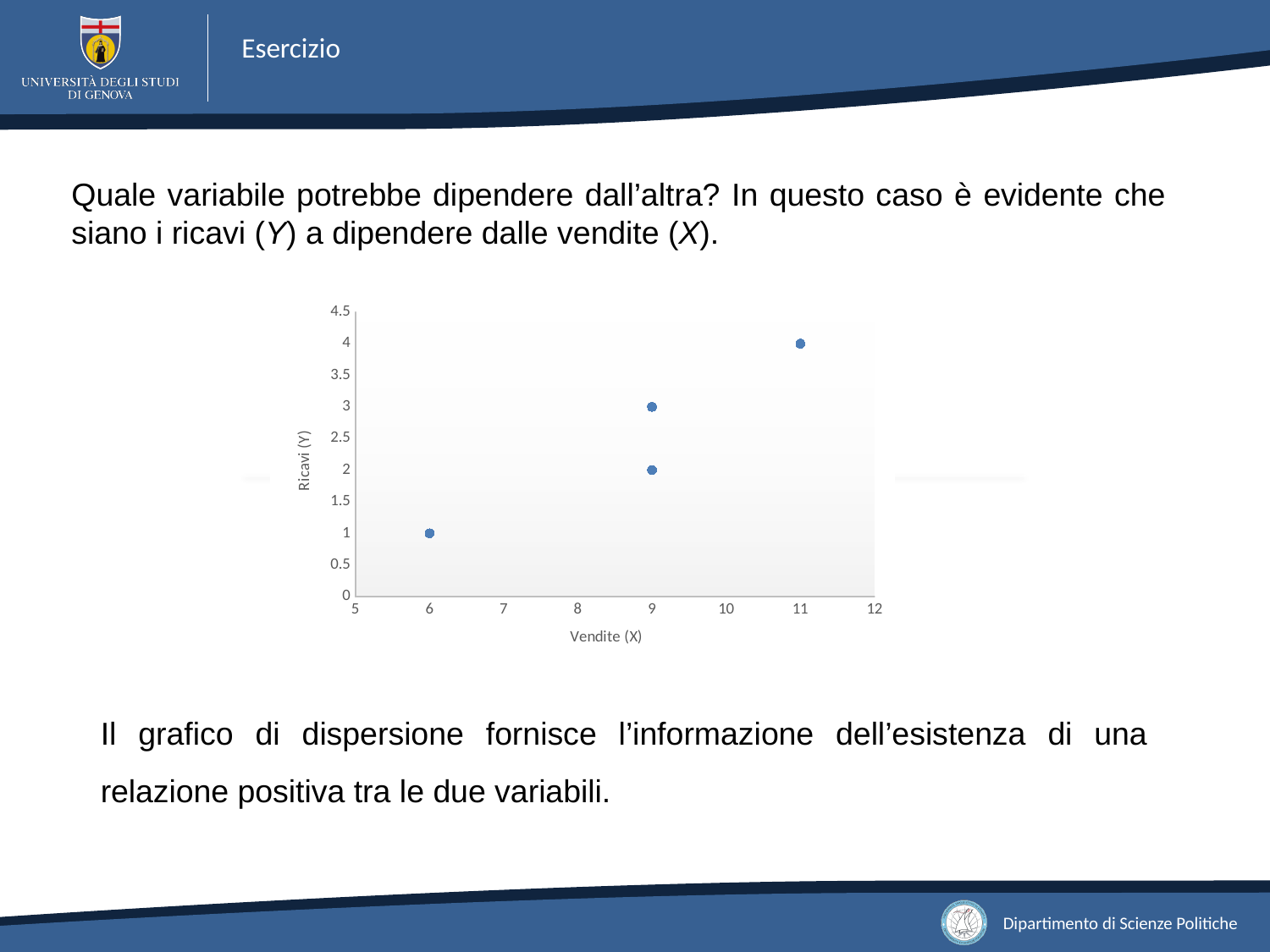
What is the difference in Ricavi (Y) between the point at Vendite (X) = 11 and the point at Vendite (X) = 6? 3 What is the highest Ricavi (Y) value plotted in the chart? 4 What is the label of the x axis of the chart? Vendite (X) What is the Ricavi (Y) value of the point at Vendite (X) = 6? 1 Which has the larger Ricavi (Y) value: the point at Vendite (X) = 6 or the point at Vendite (X) = 11? the point at Vendite (X) = 11 What kind of chart is shown on the slide? scatter plot What is the lowest Ricavi (Y) value plotted in the chart? 1 What are the Ricavi (Y) values of the two points at Vendite (X) = 9? 2 and 3 How many data points are plotted in the chart? 4 Do the Ricavi (Y) values generally rise or fall as Vendite (X) increases? rise What is the label of the y axis of the chart? Ricavi (Y) What is the Ricavi (Y) value of the point at Vendite (X) = 11? 4